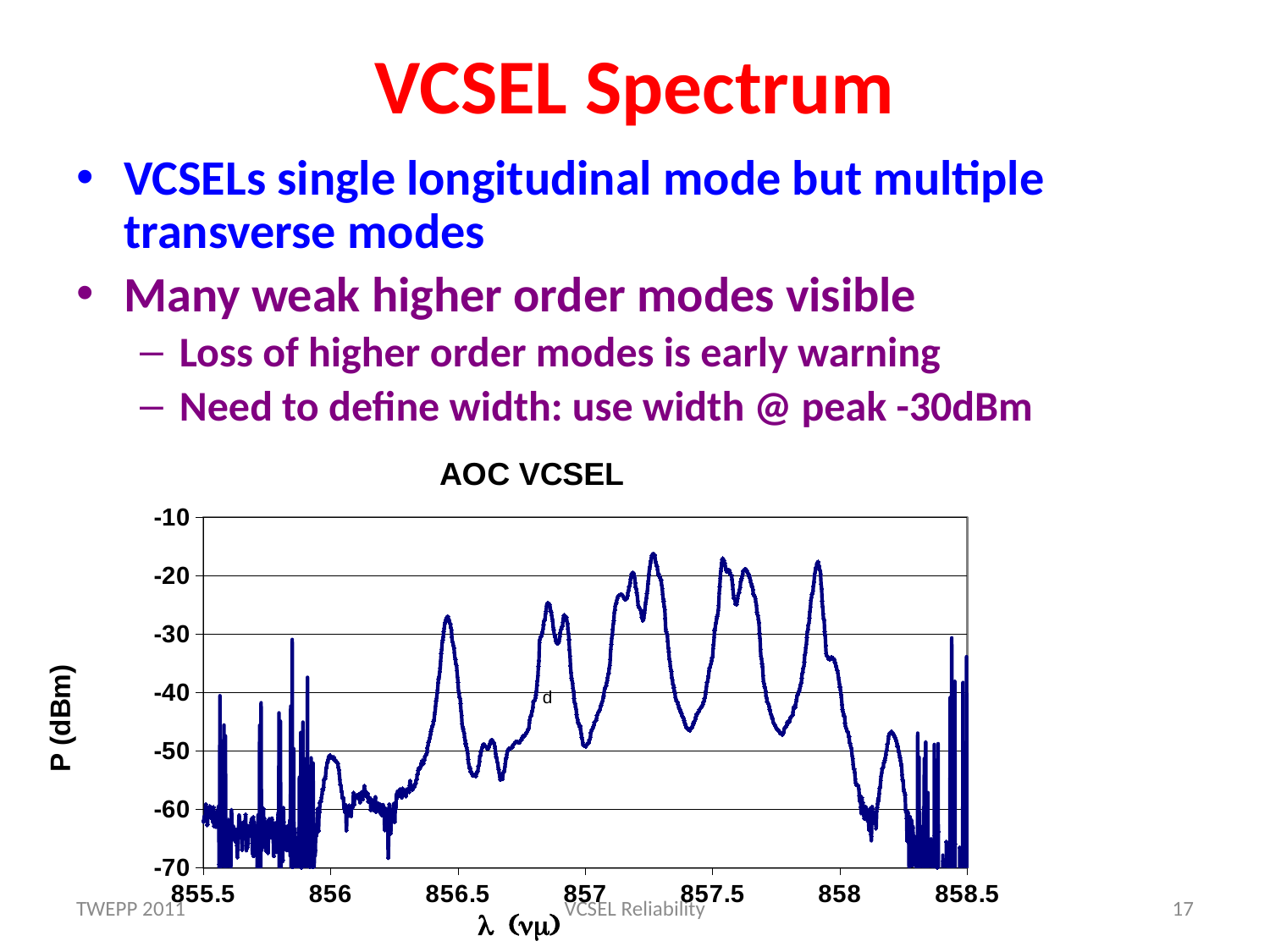
Is the highest peak of the spectrum greater or less than -20? greater What is the largest wavelength value shown on the x axis of the chart? 858.5 Is the value of the spectrum at 857.5 greater or less than -30? greater What is the highest value shown on the y axis of the chart? -10 What kind of chart is shown on the slide? line chart What is the smallest wavelength value shown on the x axis of the chart? 855.5 What is the label of the y axis of the chart? P (dBm) How many tick labels are shown on the x axis of the chart? 7 What is the lowest value shown on the y axis of the chart? -70 Is the value of the spectrum at 858 greater or less than -40? less What is the title of the chart? AOC VCSEL